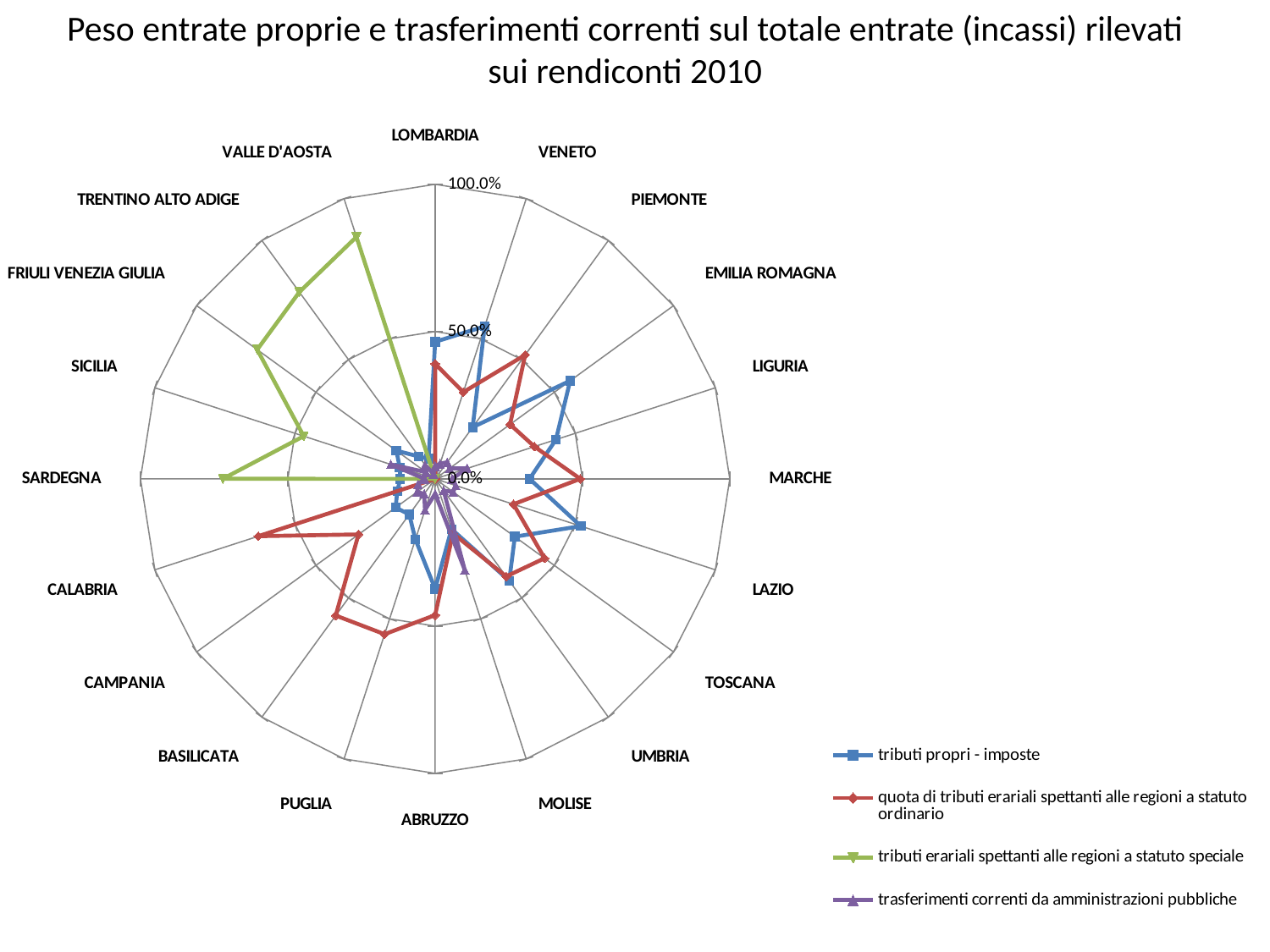
Is the value of 'tributi erariali spettanti alle regioni a statuto speciale' for Valle d'Aosta greater or less than 50.0%? greater For 'tributi erariali spettanti alle regioni a statuto speciale', which is larger: the value for Valle d'Aosta or the value for Sicilia? Valle d'Aosta Is the value of 'quota di tributi erariali spettanti alle regioni a statuto ordinario' for Calabria greater or less than 50.0%? greater Is the value of 'tributi erariali spettanti alle regioni a statuto speciale' for Sardegna greater or less than 50.0%? greater What is the title of the chart? Peso entrate proprie e trasferimenti correnti sul totale entrate (incassi) rilevati sui rendiconti 2010 What kind of chart is shown on the slide? Radar chart How many series does the legend list? 4 Which region has the highest value for 'tributi erariali spettanti alle regioni a statuto speciale'? Valle d'Aosta Which series is drawn in green? tributi erariali spettanti alle regioni a statuto speciale How many regions (categories) are plotted on the radar chart? 20